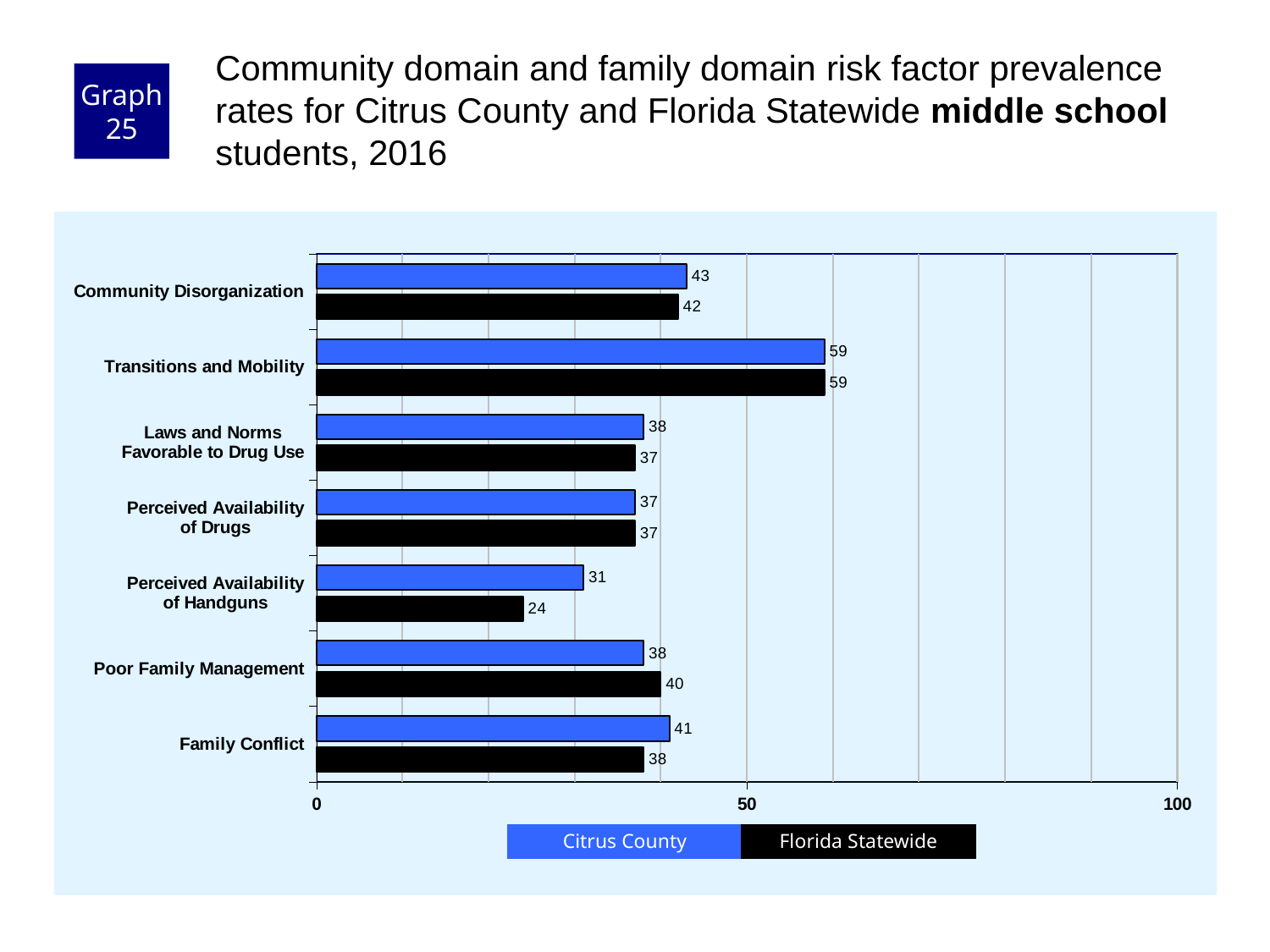
Which colour represents Florida Statewide in the chart? black What kind of chart is shown on the slide? bar chart What is the difference between the Citrus County and Florida Statewide values for Perceived Availability of Handguns? 7 Is the Citrus County value for Transitions and Mobility greater or less than 50? greater For Family Conflict, which is larger: the Citrus County value or the Florida Statewide value? Citrus County What is the Florida Statewide value for Perceived Availability of Handguns? 24 How many series does the legend list? 2 What is the Florida Statewide value for Poor Family Management? 40 What is the Citrus County value for Community Disorganization? 43 Which risk factor has the highest Citrus County value? Transitions and Mobility Which risk factor has the lowest Florida Statewide value? Perceived Availability of Handguns How many risk factor categories are shown on the chart? 7